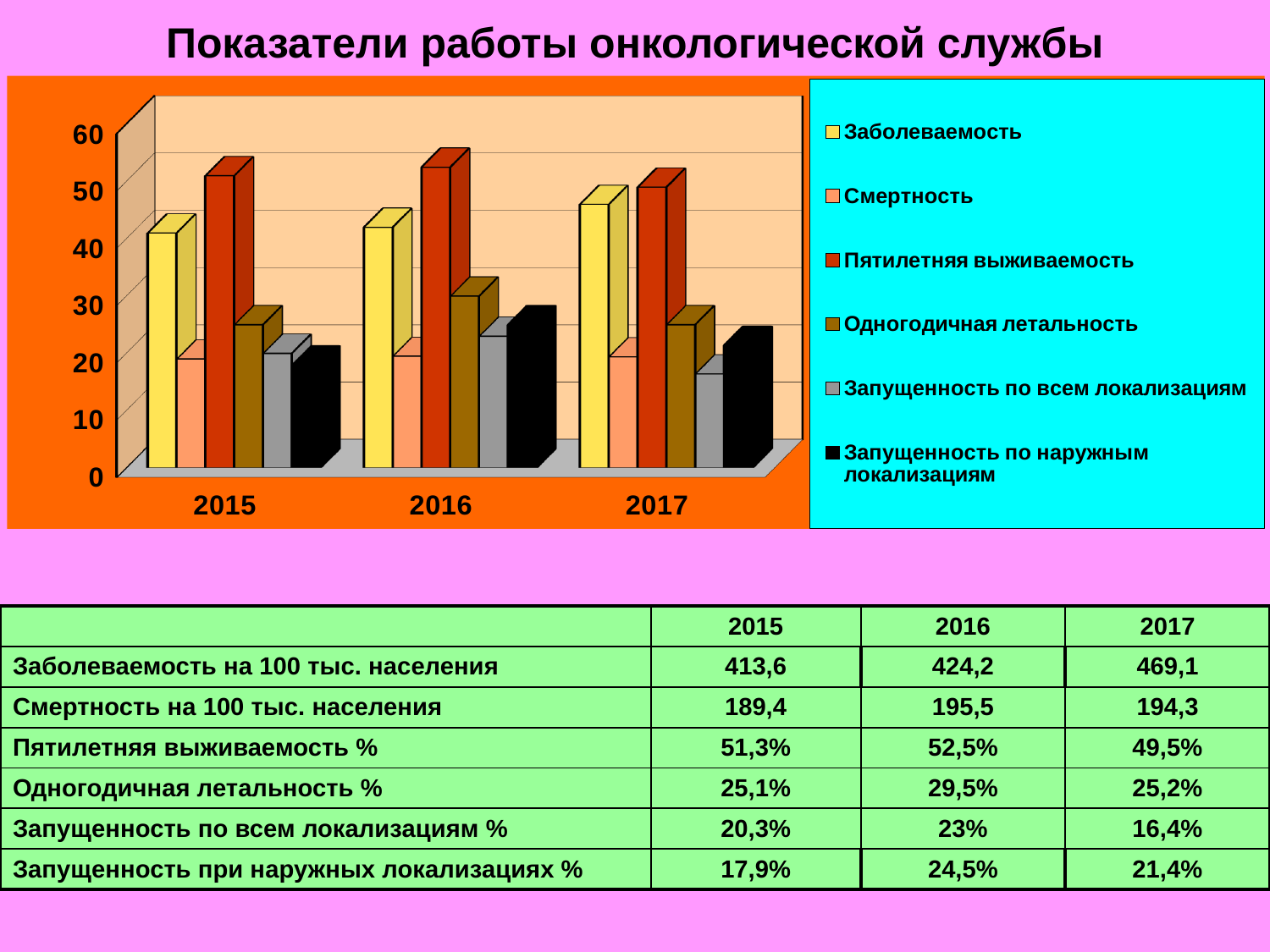
What kind of chart is shown on the slide? bar chart How many years (categories) are shown on the x axis of the chart? 3 Is the bar for Пятилетняя выживаемость in 2016 greater or less than 50? greater Do the bars for Заболеваемость rise or fall from 2015 to 2017? rise How many series does the chart legend list? 6 Is the bar for Запущенность по наружным локализациям in 2016 greater or less than 20? greater Which series has the tallest bar in 2015? Пятилетняя выживаемость What is the title of the slide above the chart? Показатели работы онкологической службы Which colour represents Пятилетняя выживаемость in the chart? red In which year is the bar for Заболеваемость the tallest? 2017 Is the bar for Запущенность по всем локализациям in 2017 greater or less than 20? less In 2016, which bar is taller: Пятилетняя выживаемость or Заболеваемость? Пятилетняя выживаемость